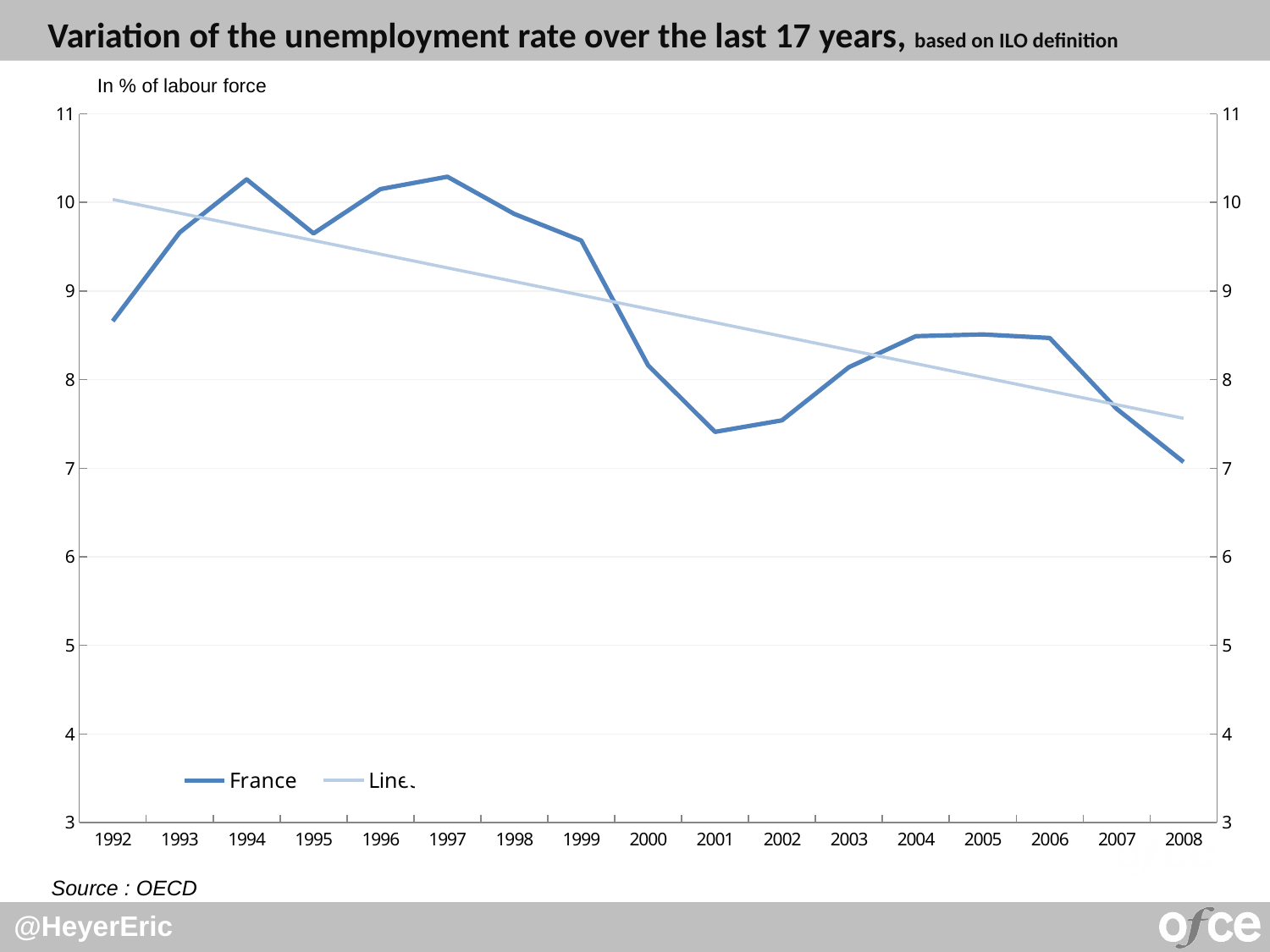
What kind of chart is shown on the slide? line chart Which year has the higher France unemployment rate, 1999 or 2000? 1999 Is the France unemployment rate in 1997 greater or less than 10? greater Does the linear trend line rise or fall from 1992 to 2008? fall How many series does the legend list? 2 Is the France unemployment rate in 2008 greater or less than 8? less How many years are plotted along the x axis? 17 Is the France unemployment rate in 2001 greater or less than 8? less What unit is given for the y axis, as stated above the chart? In % of labour force Which year has the lowest France unemployment rate on the chart? 2008 Which year has the higher France unemployment rate, 1992 or 1993? 1993